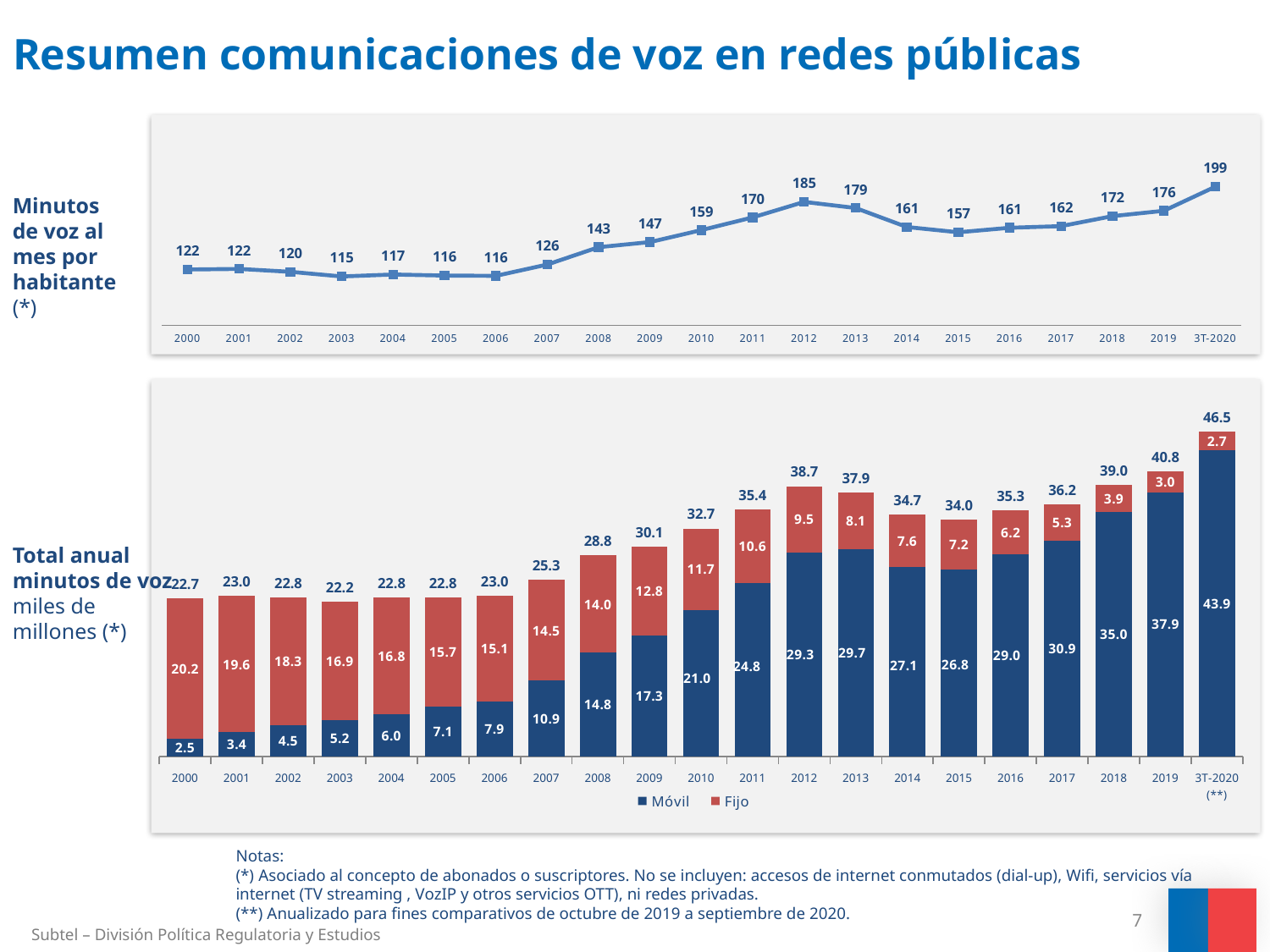
In the top chart (Minutos de voz al mes por habitante), which year has the lowest value? 2003 What kind of chart is the top chart (Minutos de voz al mes por habitante)? Line chart In the bottom chart (Total anual minutos de voz), what is the Fijo value for 2000? 20.2 In the top chart (Minutos de voz al mes por habitante), what is the value for 2012? 185 In the bottom chart (Total anual minutos de voz), which is larger in 2008: Móvil or Fijo? Móvil In the bottom chart (Total anual minutos de voz), how many series does the legend list? 2 In the bottom chart (Total anual minutos de voz), what is the total for 2012? 38.7 In the bottom chart (Total anual minutos de voz), does the Fijo value rise or fall from 2000 to 3T-2020? Fall In the top chart (Minutos de voz al mes por habitante), which year has the highest value? 3T-2020 In the top chart (Minutos de voz al mes por habitante), what is the difference between the values for 2012 and 2015? 28 In the bottom chart (Total anual minutos de voz), how many categories are shown on the x axis? 21 In the bottom chart (Total anual minutos de voz), what is the Móvil value for 2010? 21.0